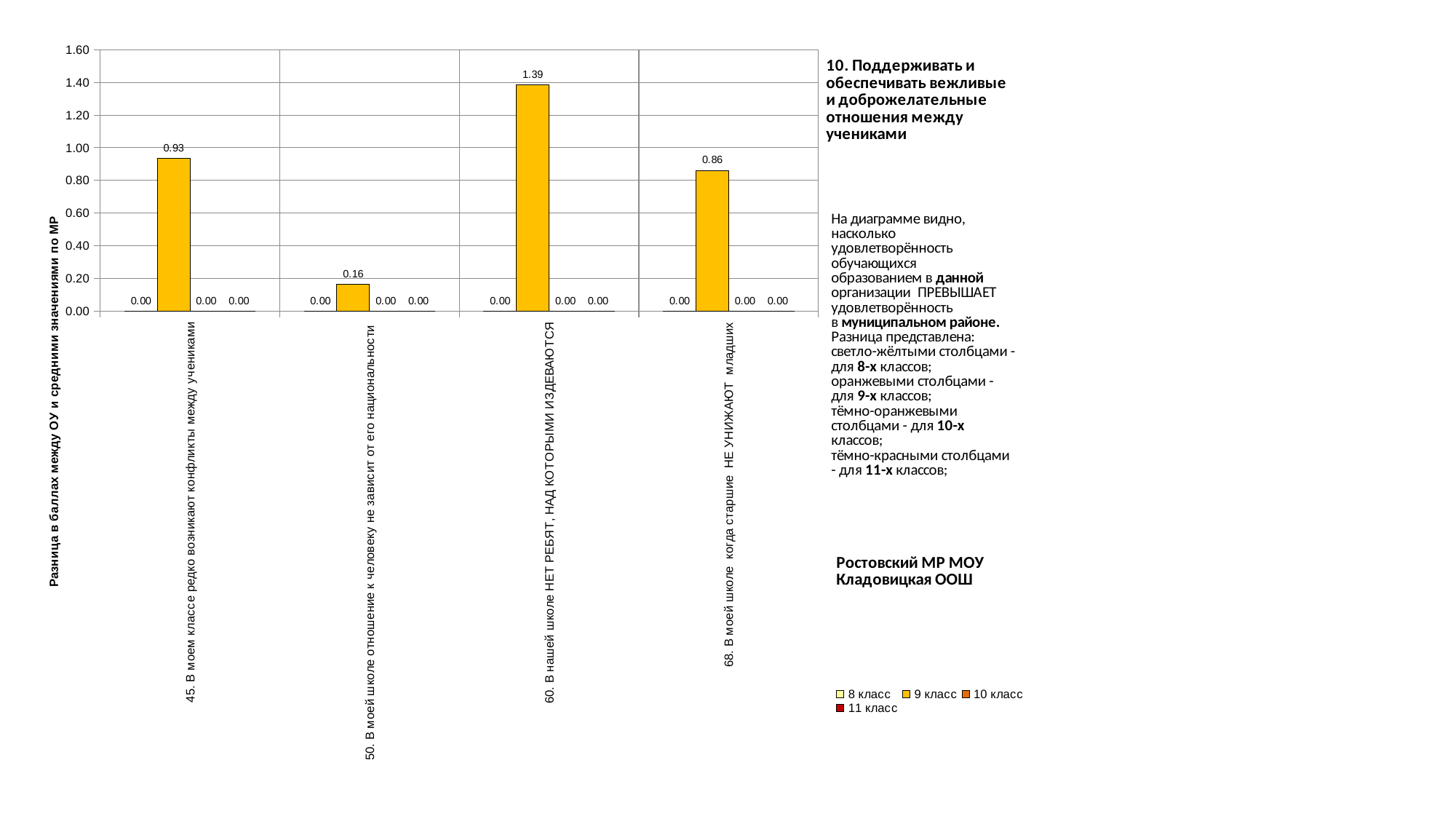
What is the value for 8 класс for category 68 (В моей школе когда старшие НЕ УНИЖАЮТ младших)? 0.00 Which category has the lowest value for 9 класс? 50. В моей школе отношение к человеку не зависит от его национальности What is the value for 9 класс for category 60 (В нашей школе НЕТ РЕБЯТ, НАД КОТОРЫМИ ИЗДЕВАЮТСЯ)? 1.39 What is the difference between the 9 класс values for category 60 and category 45? 0.46 Which is larger for 9 класс: the value for category 45 or the value for category 68? Category 45 (0.93) Which category has the highest value for 9 класс? 60. В нашей школе НЕТ РЕБЯТ, НАД КОТОРЫМИ ИЗДЕВАЮТСЯ What is the value for 9 класс for category 45 (В моем классе редко возникают конфликты между учениками)? 0.93 What is the value for 9 класс for category 50 (В моей школе отношение к человеку не зависит от его национальности)? 0.16 What is the label of the vertical axis? Разница в баллах между ОУ и средними значениями по МР What kind of chart is shown on the slide? Bar chart How many categories are shown on the x axis? 4 How many series does the legend list? 4